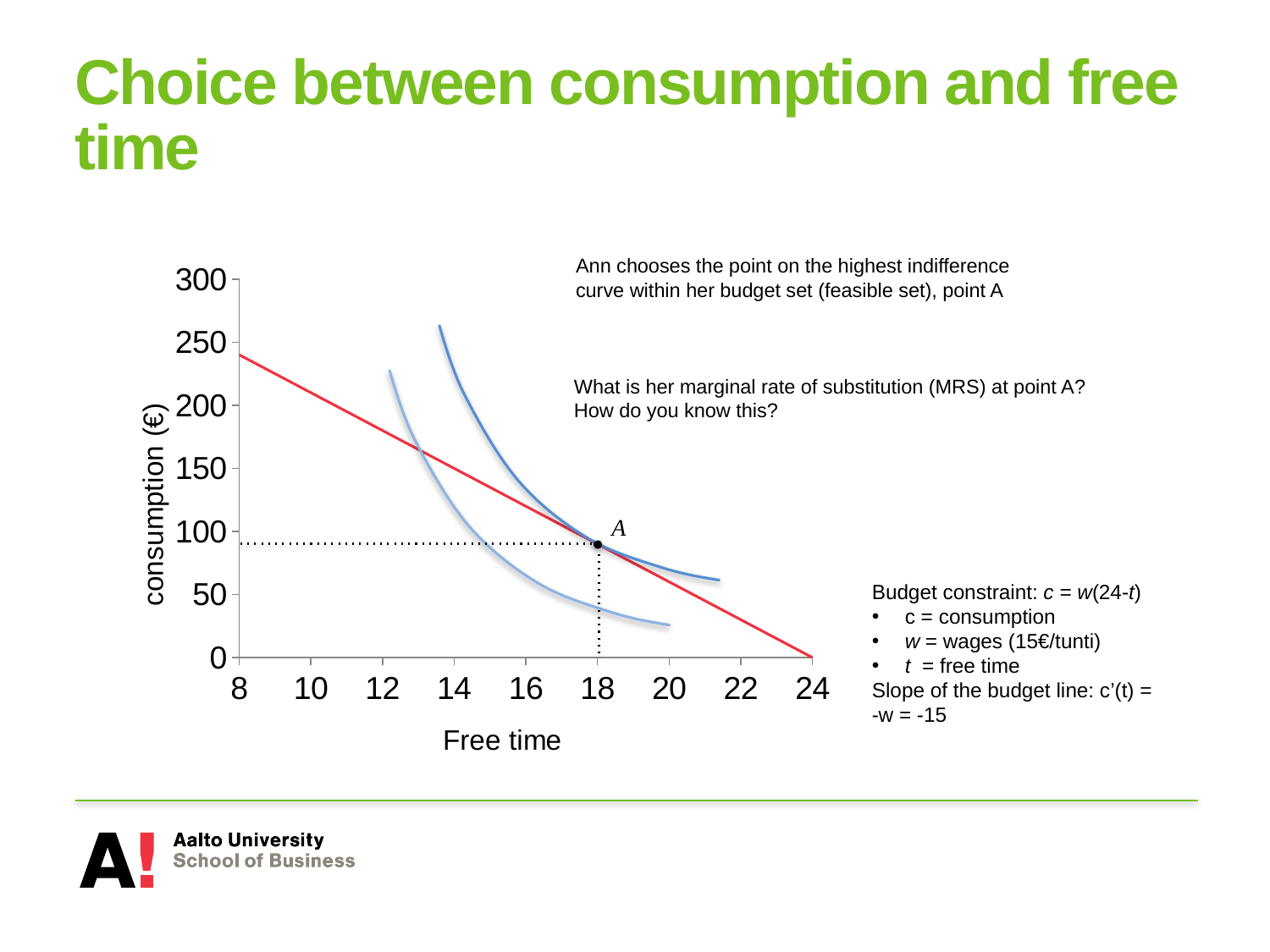
At what value of free time is point A located? 18 Is the consumption value at point A greater or less than 50? greater What is the label of the x axis? Free time How many blue indifference curves are drawn on the chart? 2 Is the consumption value on the red budget line at free time 14 greater or less than 100? greater Is the consumption value at point A greater or less than 100? less Does consumption along the red budget line rise or fall as free time increases? fall What type of chart is shown on the slide? line chart What is the label of the y axis? consumption (€) What is the highest value shown on the y axis? 300 At what value of free time does the red budget line reach a consumption of 0? 24